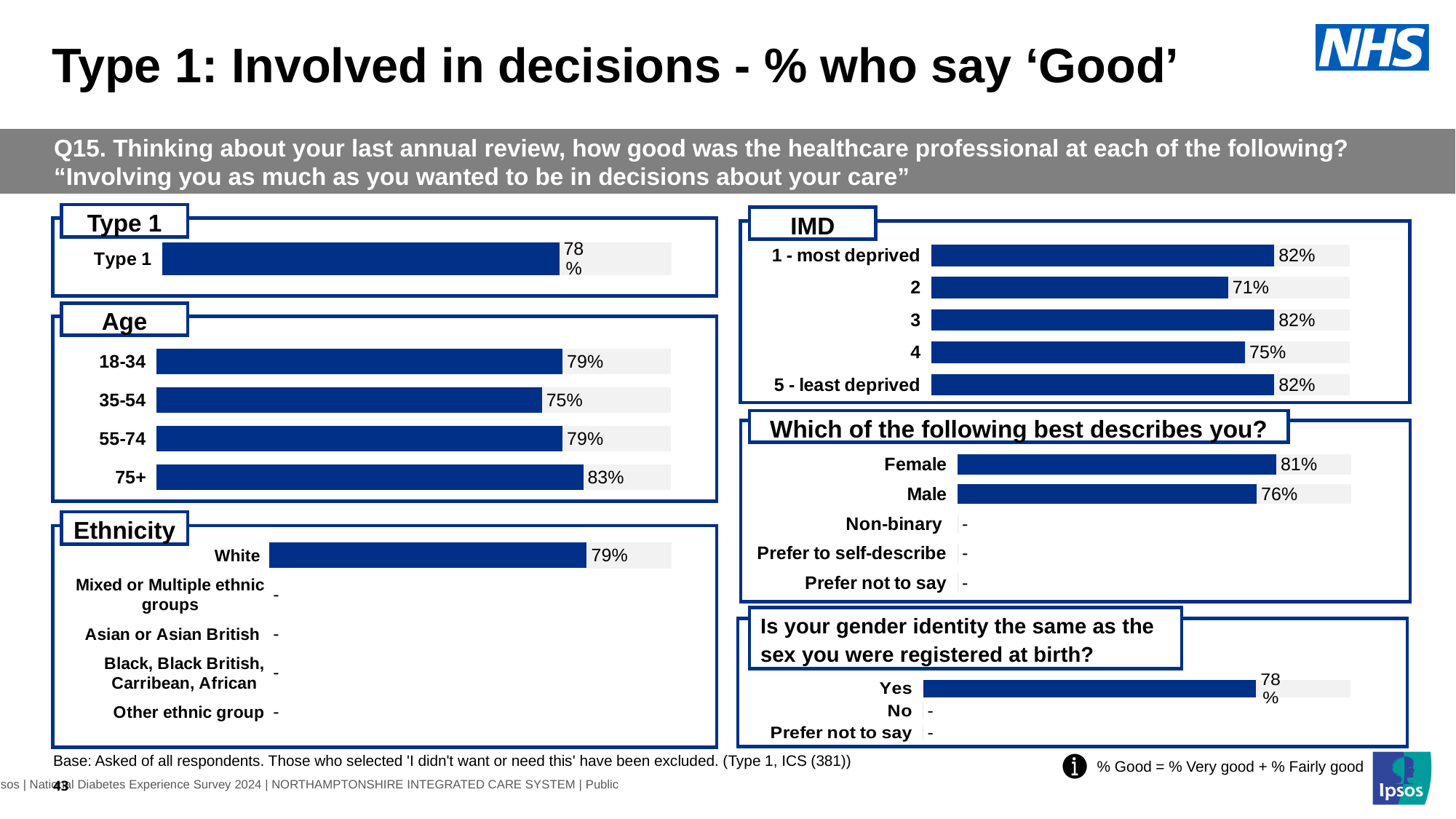
In the Ethnicity chart, what is the value for White respondents? 79% In the 'Is your gender identity the same as the sex you were registered at birth?' chart, what is the value for Yes? 78% In the Age chart, which age group has the lowest value? 35-54 In the Age chart, what is the value for the 35-54 age group? 75% In the 'Which of the following best describes you?' chart, which is larger, the value for Female or for Male? Female In the Type 1 chart, what percentage of Type 1 respondents say 'Good'? 78% In the IMD chart, which IMD group has the lowest value? 2 In the 'Which of the following best describes you?' chart, what is the difference between the Female and Male values? 5 percentage points In the Age chart, what is the difference between the 75+ and 35-54 values? 8 percentage points In the IMD chart, how many IMD categories are shown? 5 In the IMD chart, what is the value for IMD group 2? 71% In the Age chart, which age group has the highest value? 75+